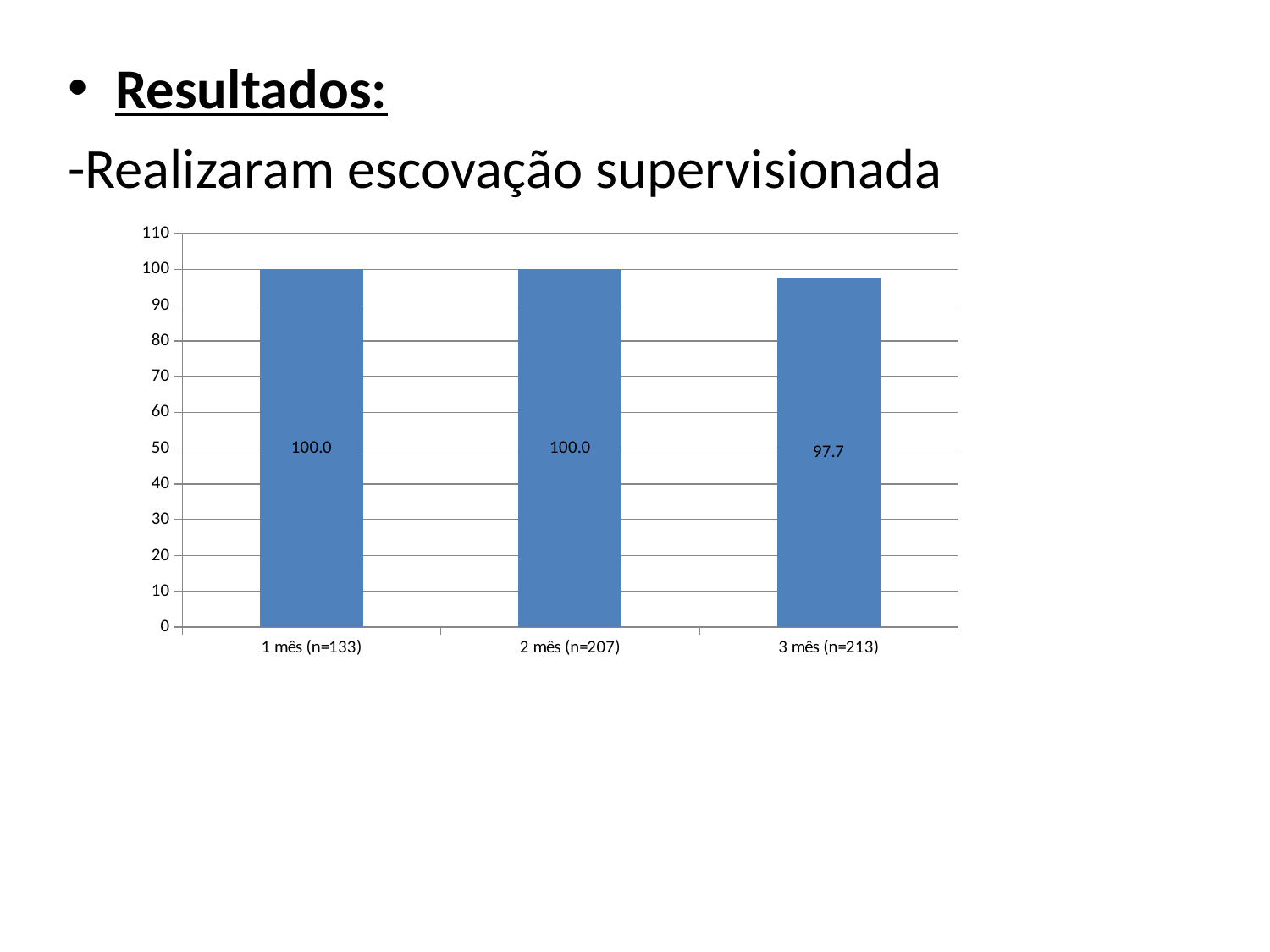
What is the value for 3 mês (n=213)? 97.7 What is the value for 1 mês (n=133)? 100.0 What kind of chart is shown on the slide? bar chart What is the highest tick value shown on the y axis? 110 What colour are the bars in the chart? blue Which category has the lowest value? 3 mês (n=213) What is the value for 2 mês (n=207)? 100.0 Do the values rise or fall from 2 mês (n=207) to 3 mês (n=213)? fall Which is larger, the value for 2 mês (n=207) or 3 mês (n=213)? 2 mês (n=207) How many categories are shown on the x axis? 3 What is the difference between the values for 1 mês (n=133) and 3 mês (n=213)? 2.3 Is the value for 3 mês (n=213) greater or less than 90? greater